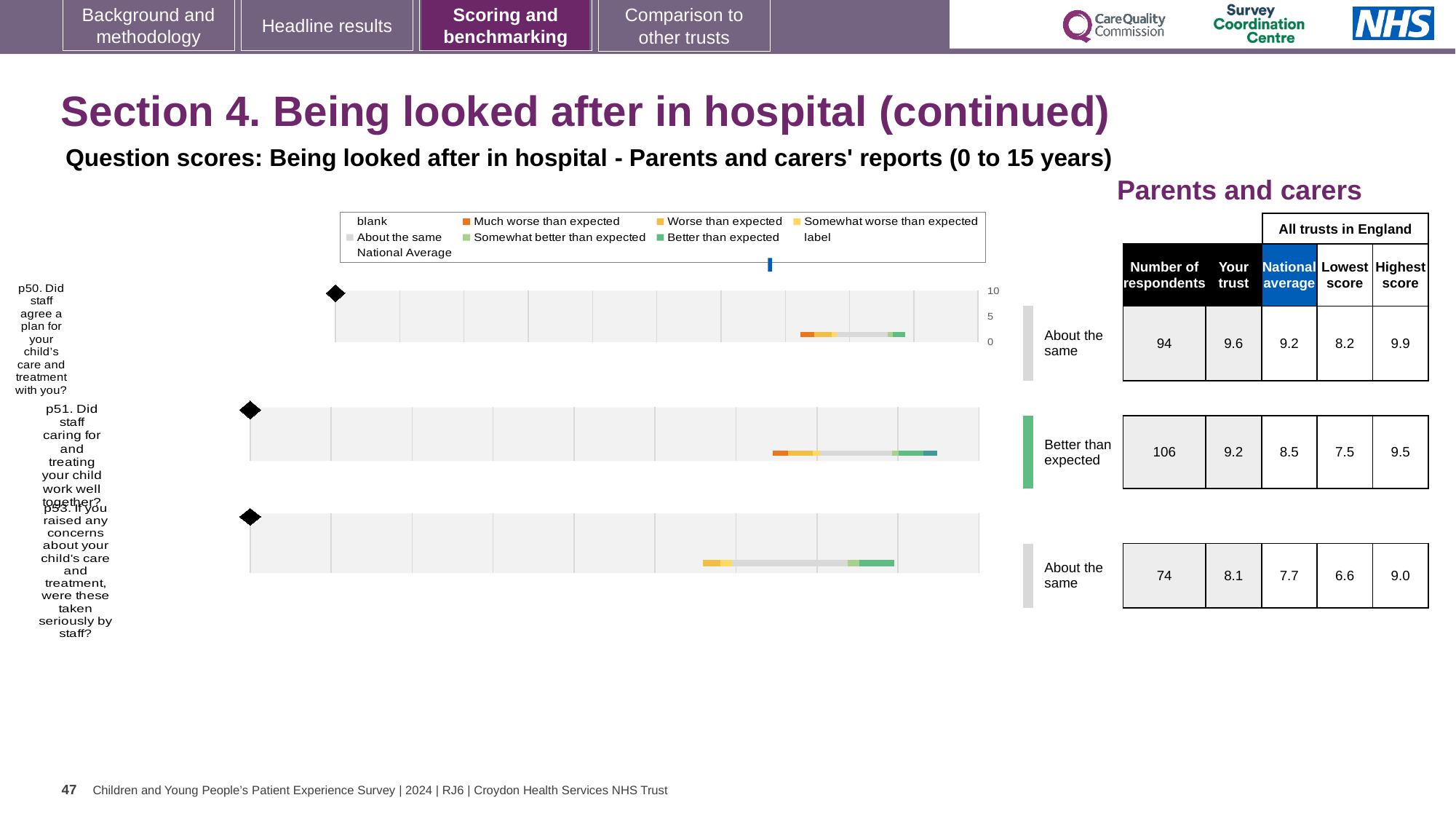
What is the national average score for question p53 (If you raised any concerns about your child's care and treatment, were these taken seriously by staff)? 7.7 What is the 'Your trust' score for question p51 (Did staff caring for and treating your child work well together)? 9.2 Which has the higher 'Your trust' score, question p50 or question p53? p50 For question p51, what is the difference between the 'Your trust' score and the national average? 0.7 What kind of chart is used to show the question scores? Bar chart How many questions are plotted on the slide? 3 What is the lowest score among all trusts in England for question p51? 7.5 What is the highest score among all trusts in England for question p50? 9.9 How many respondents are shown for question p50 (Did staff agree a plan for your child's care and treatment with you)? 94 Which question has the lowest 'Your trust' score? p53 Which question has the largest number of respondents? p51 What benchmark category is shown for question p51? Better than expected